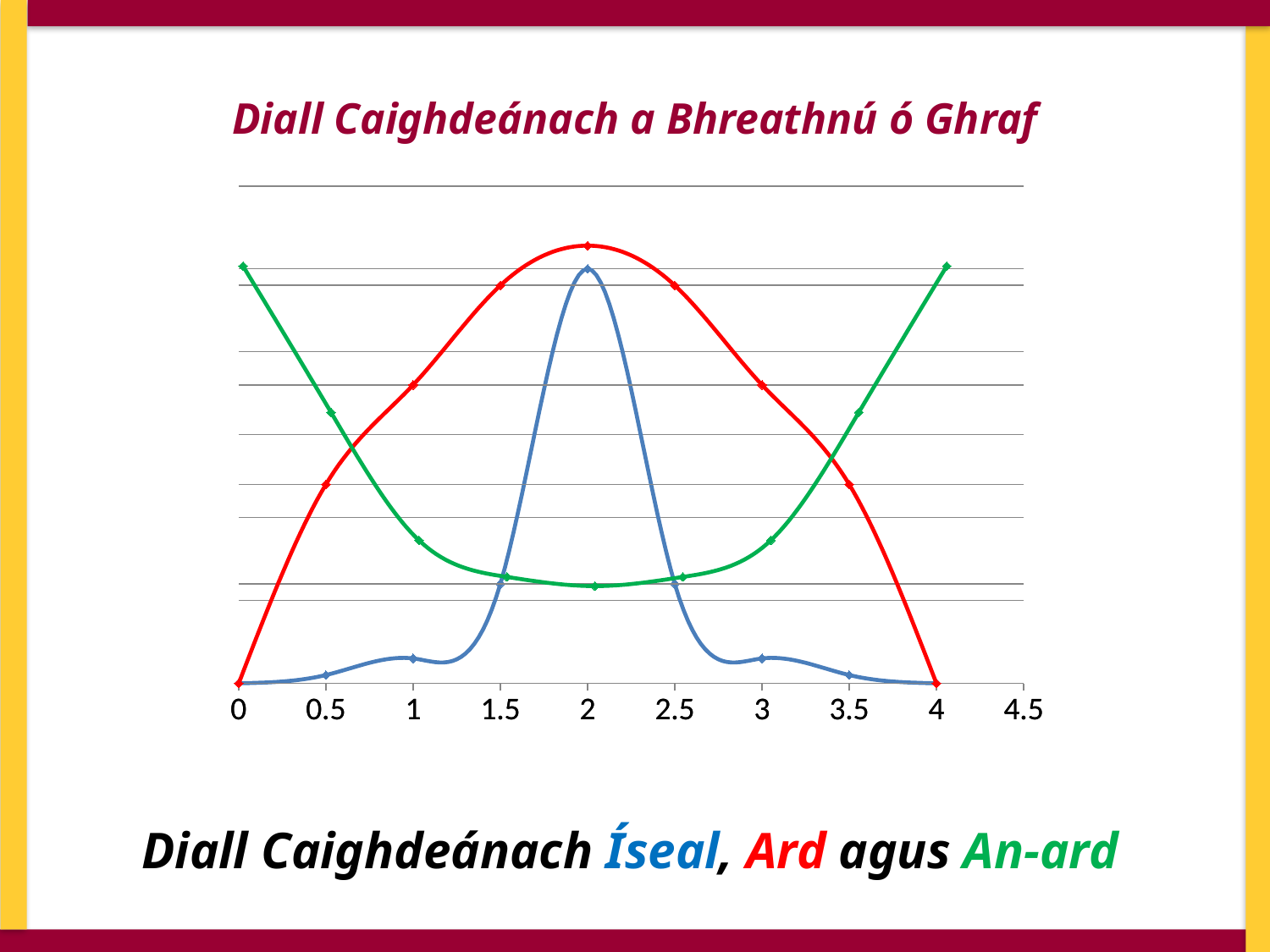
Does the red line rise or fall between x = 0 and x = 2? rise Which line is highest at x = 0? the green line What is the largest value labelled on the x axis? 4.5 At x = 1, is the red line or the blue line higher? the red line Does the green line rise or fall between x = 0 and x = 2? fall Which line reaches the highest point at x = 2? the red line Which line is lowest at x = 2? the green line What is the title of the chart? Diall Caighdeánach a Bhreathnú ó Ghraf How many lines are plotted on the chart? 3 What kind of chart is shown on the slide? line chart At x = 0.5, is the green line or the red line higher? the green line How many tick labels are shown on the x axis? 10